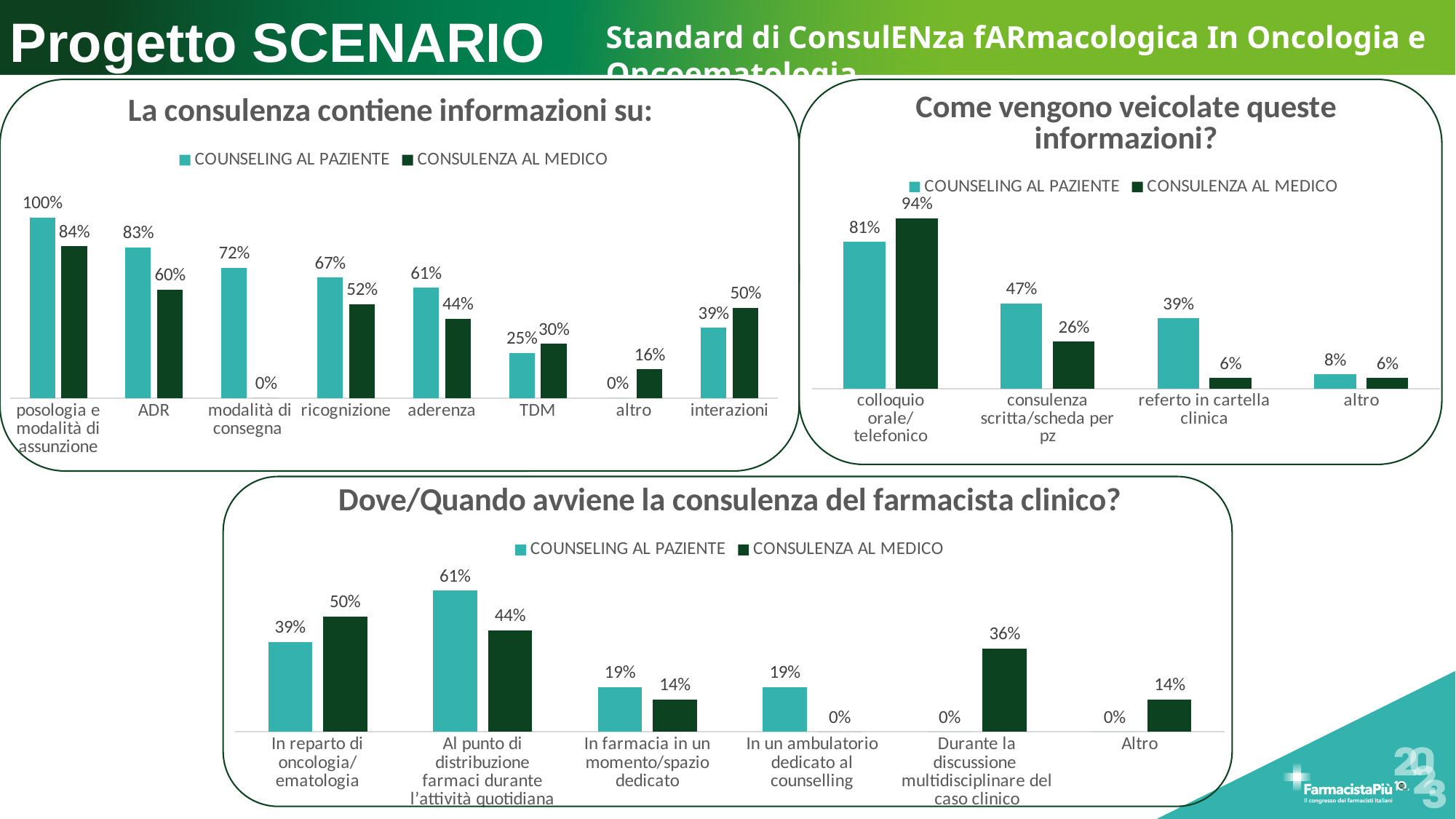
In the chart 'La consulenza contiene informazioni su:', how many categories are shown on the x axis? 8 In the chart 'Dove/Quando avviene la consulenza del farmacista clinico?', which category has the highest value for COUNSELING AL PAZIENTE? Al punto di distribuzione farmaci durante l'attività quotidiana In the chart 'La consulenza contiene informazioni su:', what is the value for COUNSELING AL PAZIENTE for ADR? 83% In the chart 'Come vengono veicolate queste informazioni?', what is the value for CONSULENZA AL MEDICO for colloquio orale/telefonico? 94% In the chart 'Come vengono veicolate queste informazioni?', which is larger for consulenza scritta/scheda per pz: COUNSELING AL PAZIENTE or CONSULENZA AL MEDICO? COUNSELING AL PAZIENTE In the chart 'Come vengono veicolate queste informazioni?', which category has the lowest value for CONSULENZA AL MEDICO? referto in cartella clinica and altro (both 6%) In the chart 'La consulenza contiene informazioni su:', what is the difference between COUNSELING AL PAZIENTE and CONSULENZA AL MEDICO for ricognizione? 15% In the chart 'Dove/Quando avviene la consulenza del farmacista clinico?', what is the value for CONSULENZA AL MEDICO for 'Durante la discussione multidisciplinare del caso clinico'? 36% What kind of chart is 'Dove/Quando avviene la consulenza del farmacista clinico?'? bar chart In the chart 'La consulenza contiene informazioni su:', what is the value for CONSULENZA AL MEDICO for modalità di consegna? 0% In the chart 'La consulenza contiene informazioni su:', which category has the highest value for COUNSELING AL PAZIENTE? posologia e modalità di assunzione In the chart 'Come vengono veicolate queste informazioni?', how many series does the legend list? 2